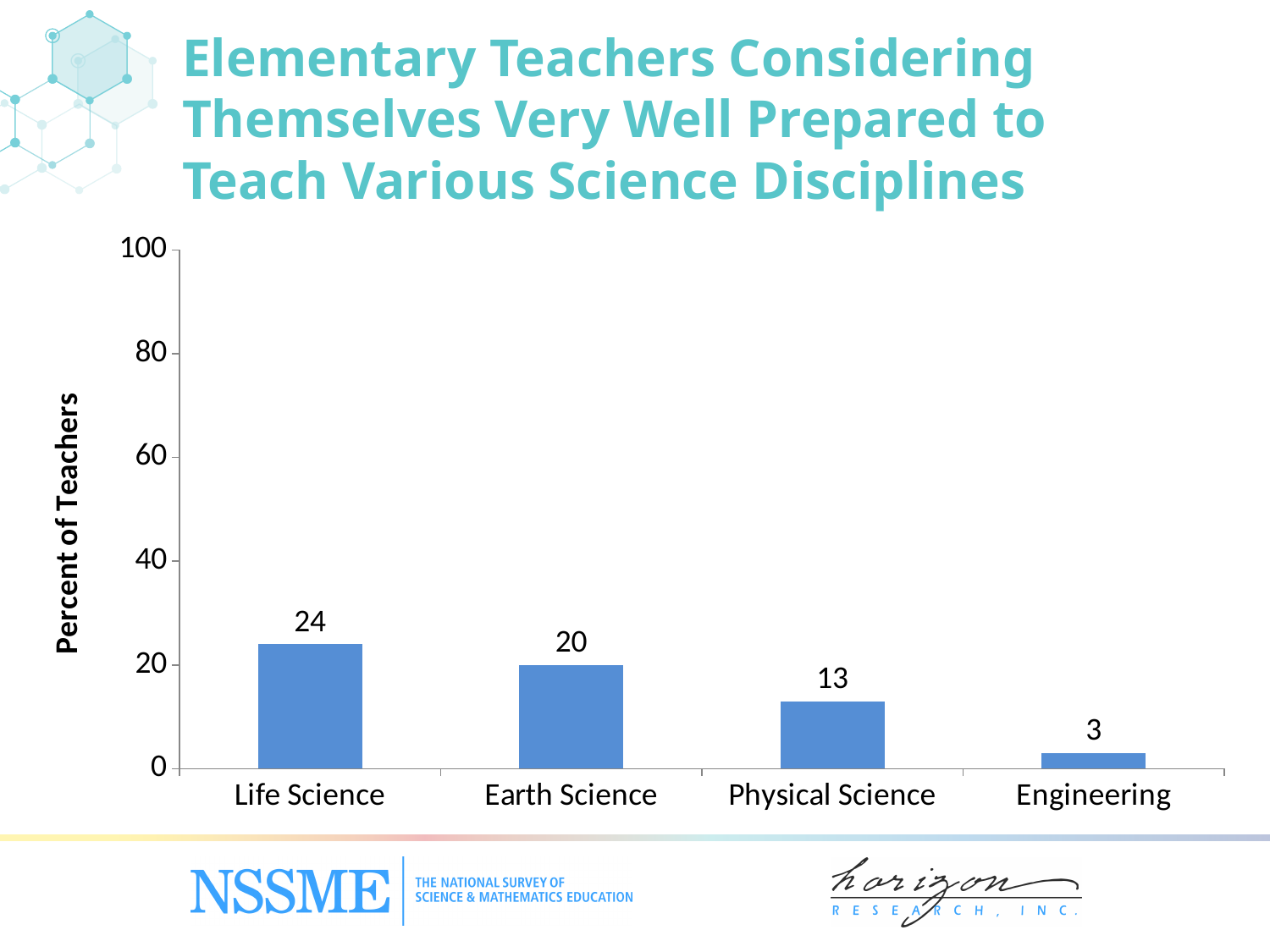
What is the value for Physical Science? 13 How many disciplines are shown on the x axis? 4 Which is larger, the value for Earth Science or the value for Physical Science? Earth Science What is the difference between the values for Physical Science and Engineering? 10 What kind of chart is shown on the slide? Bar chart Which discipline has the highest percent of teachers? Life Science Which discipline has the lowest percent of teachers? Engineering What is the value for Life Science? 24 What is the value for Engineering? 3 What is the value for Earth Science? 20 What is the label of the y axis? Percent of Teachers What is the difference between the values for Life Science and Earth Science? 4